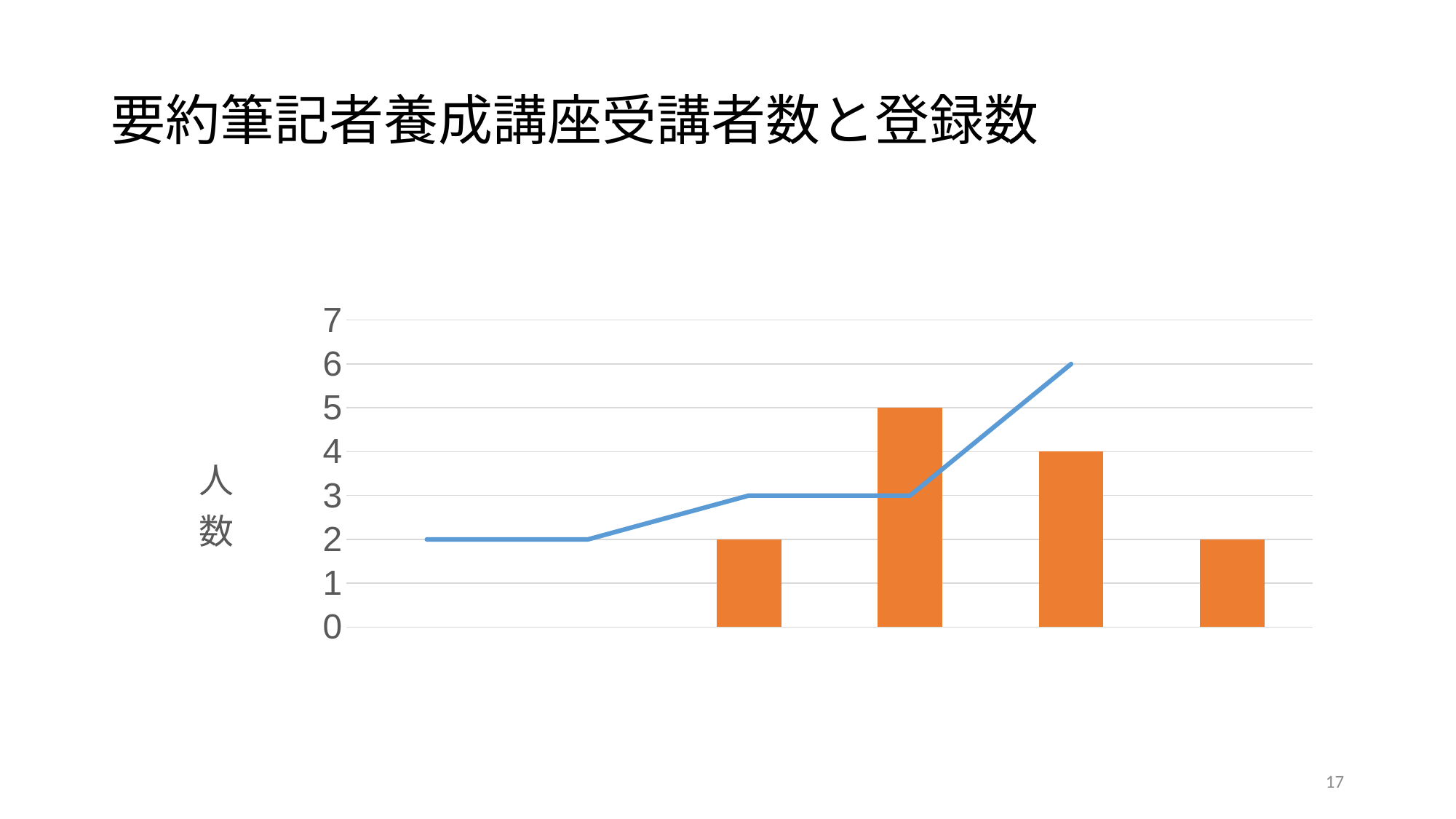
What is the difference between the second orange bar (5) and the third orange bar (4)? 1 What is the value of the tallest orange bar? 5 How many data points does the blue line have? 5 What is the value of the last (rightmost) point on the blue line? 6 How many orange bars are plotted in the chart? 4 What is the label on the vertical axis of the chart? 人数 What is the value of the lowest orange bars? 2 What kind of chart is shown on the slide? A combination bar and line chart What is the value of the first (leftmost) point on the blue line? 2 Does the blue line rise or fall overall from left to right? Rises What is the value of the third orange bar from the left? 4 Which is larger: the final point of the blue line or the tallest orange bar? The final point of the blue line